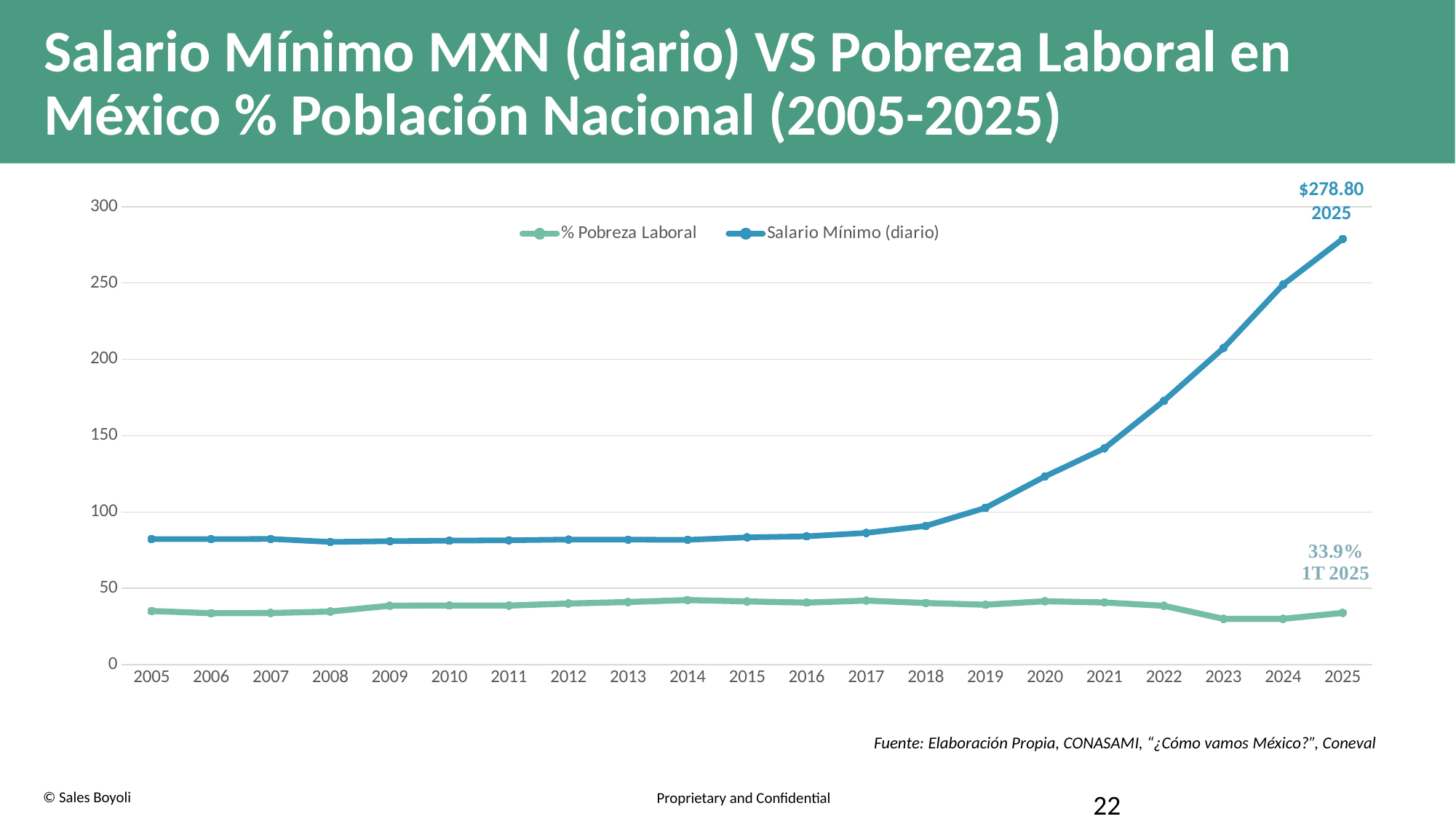
How many series does the legend list? 2 What is the value of Salario Mínimo (diario) in 2025? $278.80 Is the value for Salario Mínimo (diario) in 2015 greater or less than 100? less Does Salario Mínimo (diario) rise or fall from 2018 to 2025? rise In which year is Salario Mínimo (diario) highest? 2025 Is the value for % Pobreza Laboral in 2014 greater or less than 50? less What kind of chart is shown on the slide? line chart How many years are plotted along the x axis? 21 What is the value of % Pobreza Laboral labelled for 1T 2025? 33.9% Is the value for Salario Mínimo (diario) in 2020 greater or less than 100? greater Which series is drawn in blue according to the legend? Salario Mínimo (diario)